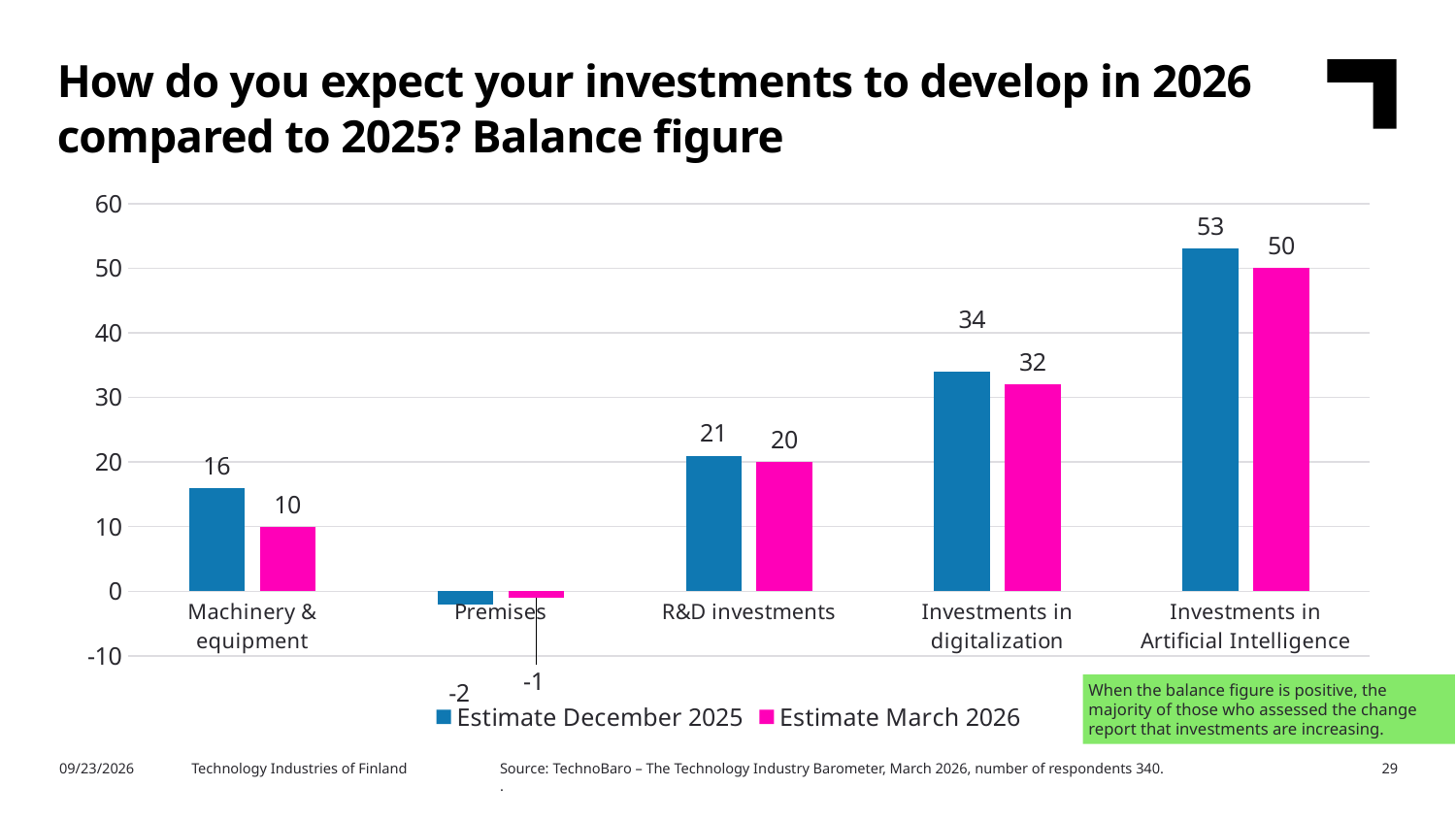
Which category has the lowest Estimate March 2026 value? Premises What colour are the Estimate March 2026 bars? Magenta (pink) How many series does the legend list? 2 What is the Estimate March 2026 value for Investments in Artificial Intelligence? 50 What kind of chart is shown on the slide? Bar chart What is the Estimate December 2025 value for Investments in digitalization? 34 What is the Estimate December 2025 value for Premises? -2 What is the difference between the Estimate December 2025 and Estimate March 2026 values for Machinery & equipment? 6 Which is larger for R&D investments: the Estimate December 2025 value or the Estimate March 2026 value? Estimate December 2025 Which category has the highest Estimate December 2025 value? Investments in Artificial Intelligence How many categories are shown on the x axis? 5 Is the Estimate March 2026 value for Investments in digitalization greater or less than 30? greater